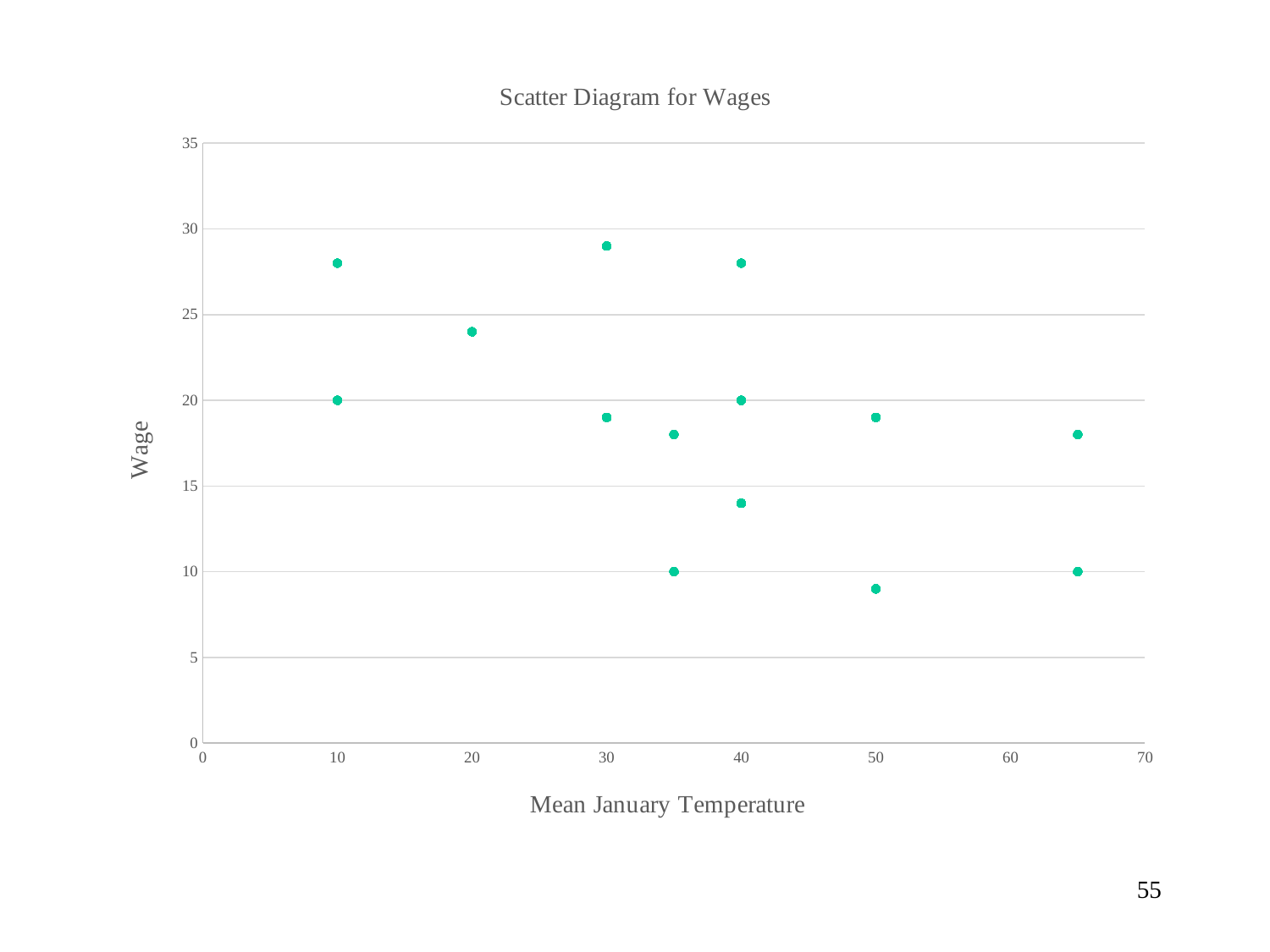
Is the wage for the lower point at a mean January temperature of 50 greater or less than 15? less Is the wage for the higher point at a mean January temperature of 10 greater or less than 25? greater How many data points are plotted on the chart? 14 Is the wage for the point at a mean January temperature of 20 greater or less than 20? greater What type of chart is shown on the slide? Scatter chart What is the title of the chart? Scatter Diagram for Wages What is the wage for the lower of the two points at a mean January temperature of 35? 10 What is the wage for the lower of the two points at a mean January temperature of 10? 20 What is the label of the x axis? Mean January Temperature What is the wage for the lowest point at a mean January temperature of 65? 10 Which is larger: the wage for the point at temperature 20 or the wage for the lower point at temperature 10? The point at temperature 20